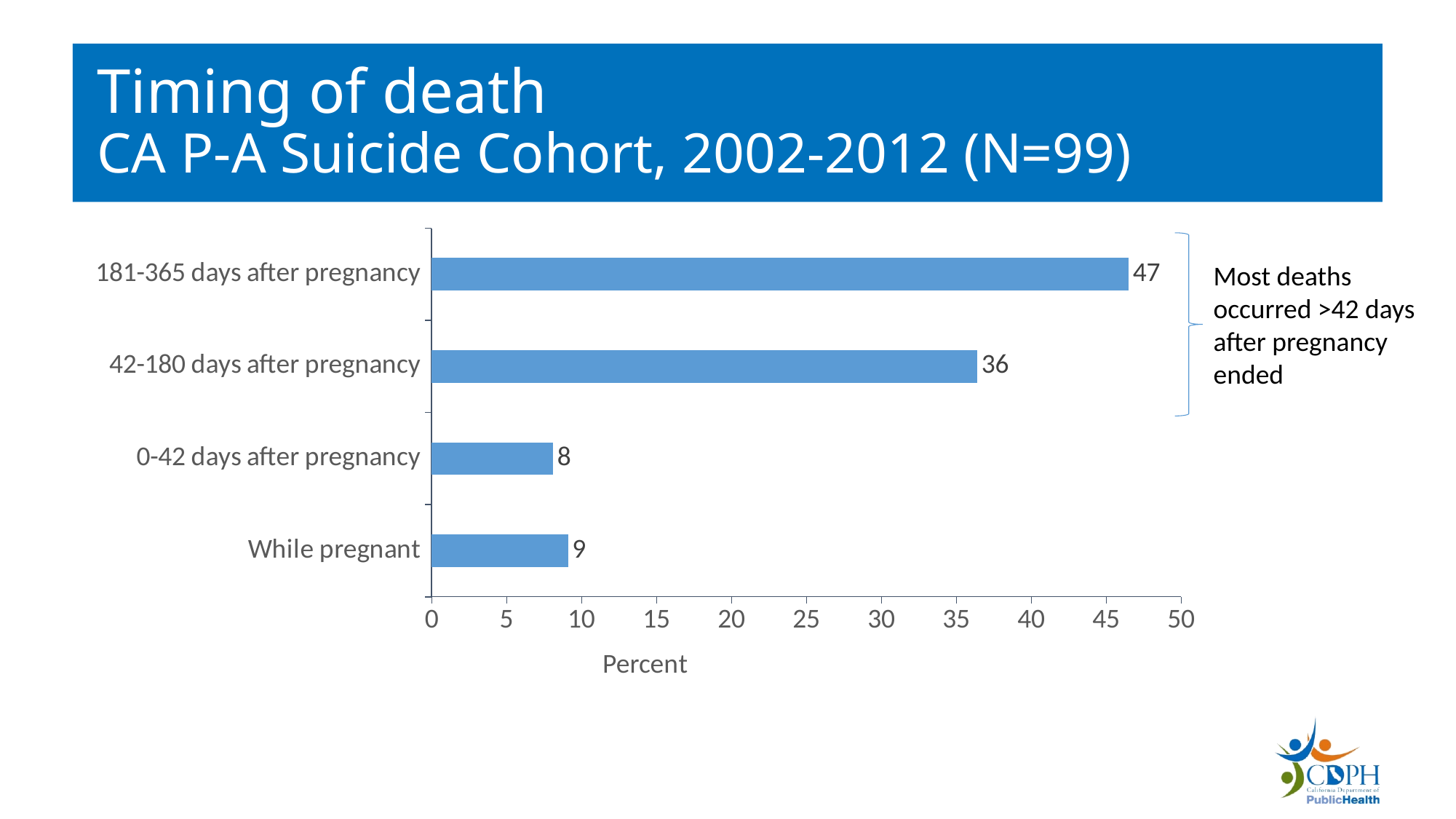
Which category has the highest value? 181-365 days after pregnancy What kind of chart is shown on the slide? bar chart Is the value for 42-180 days after pregnancy greater or less than 30? greater What is the value for 0-42 days after pregnancy? 8 What is the difference between the values for 181-365 days after pregnancy and 42-180 days after pregnancy? 11 Which is larger, the value for While pregnant or the value for 0-42 days after pregnancy? While pregnant What is the label of the horizontal axis? Percent What is the value for 181-365 days after pregnancy? 47 Which category has the lowest value? 0-42 days after pregnancy What is the value for 42-180 days after pregnancy? 36 How many categories are shown in the chart? 4 What is the value for While pregnant? 9